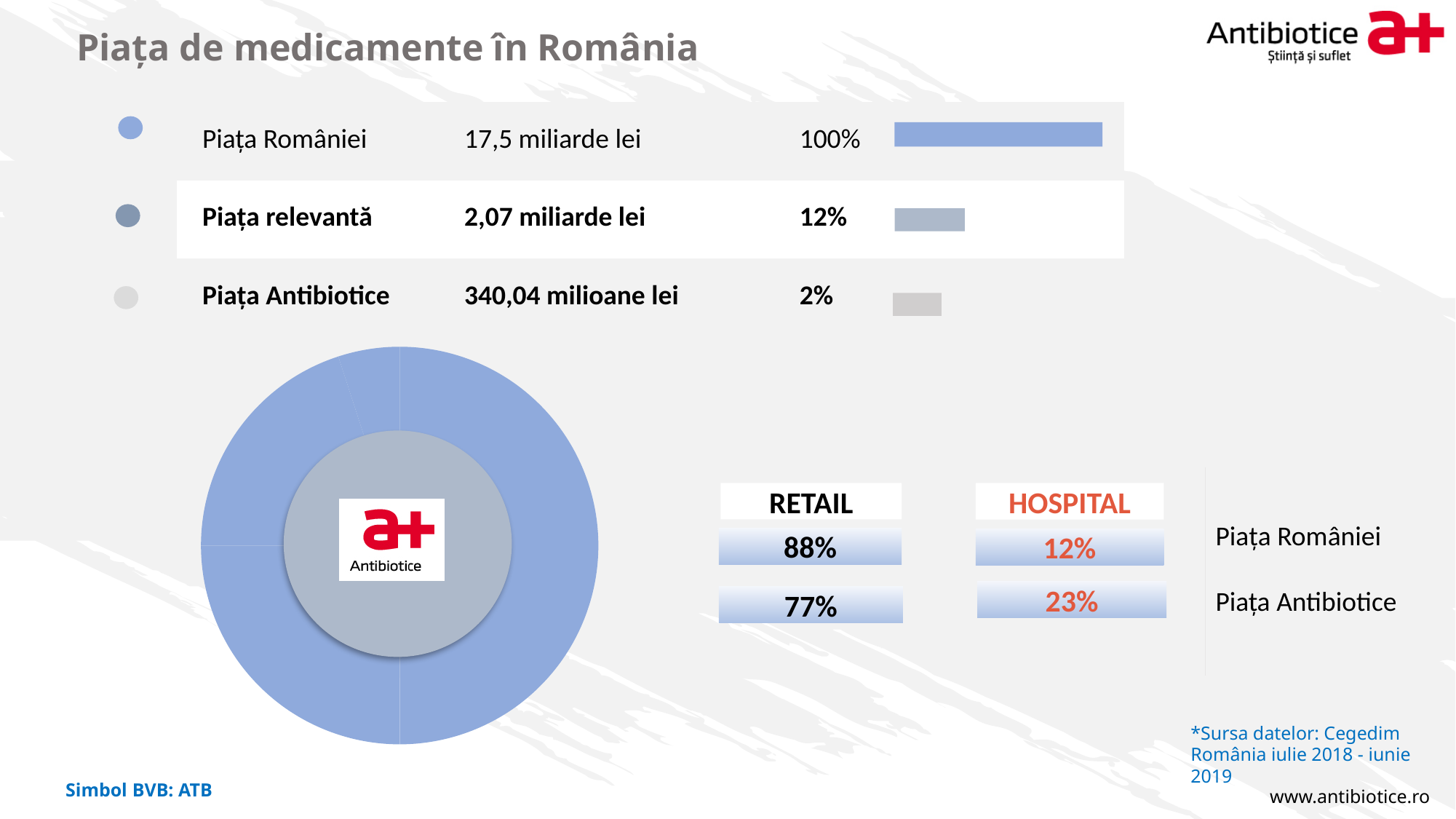
In the bar chart at the top of the slide, which category has the largest bar? Piața României In the RETAIL / HOSPITAL table on the right, what is the HOSPITAL share for Piața Antibiotice? 23% In the bar chart at the top of the slide, how many categories are shown? 3 In the bar chart at the top of the slide, what is the difference in percentage points between Piața relevantă and Piața Antibiotice? 10% In the bar chart at the top of the slide, what percentage is shown for Piața Antibiotice? 2% In the bar chart at the top of the slide, what is the value shown for Piața Antibiotice? 340,04 milioane lei In the bar chart at the top of the slide, what percentage is shown for Piața relevantă? 12% In the bar chart at the top of the slide, what is the value shown for Piața relevantă? 2,07 miliarde lei In the bar chart at the top of the slide, what is the value shown for Piața României? 17,5 miliarde lei In the bar chart at the top of the slide, which category has the smallest bar? Piața Antibiotice In the RETAIL / HOSPITAL table on the right, which has the larger HOSPITAL share, Piața României or Piața Antibiotice? Piața Antibiotice In the RETAIL / HOSPITAL table on the right, what is the RETAIL share for Piața României? 88%